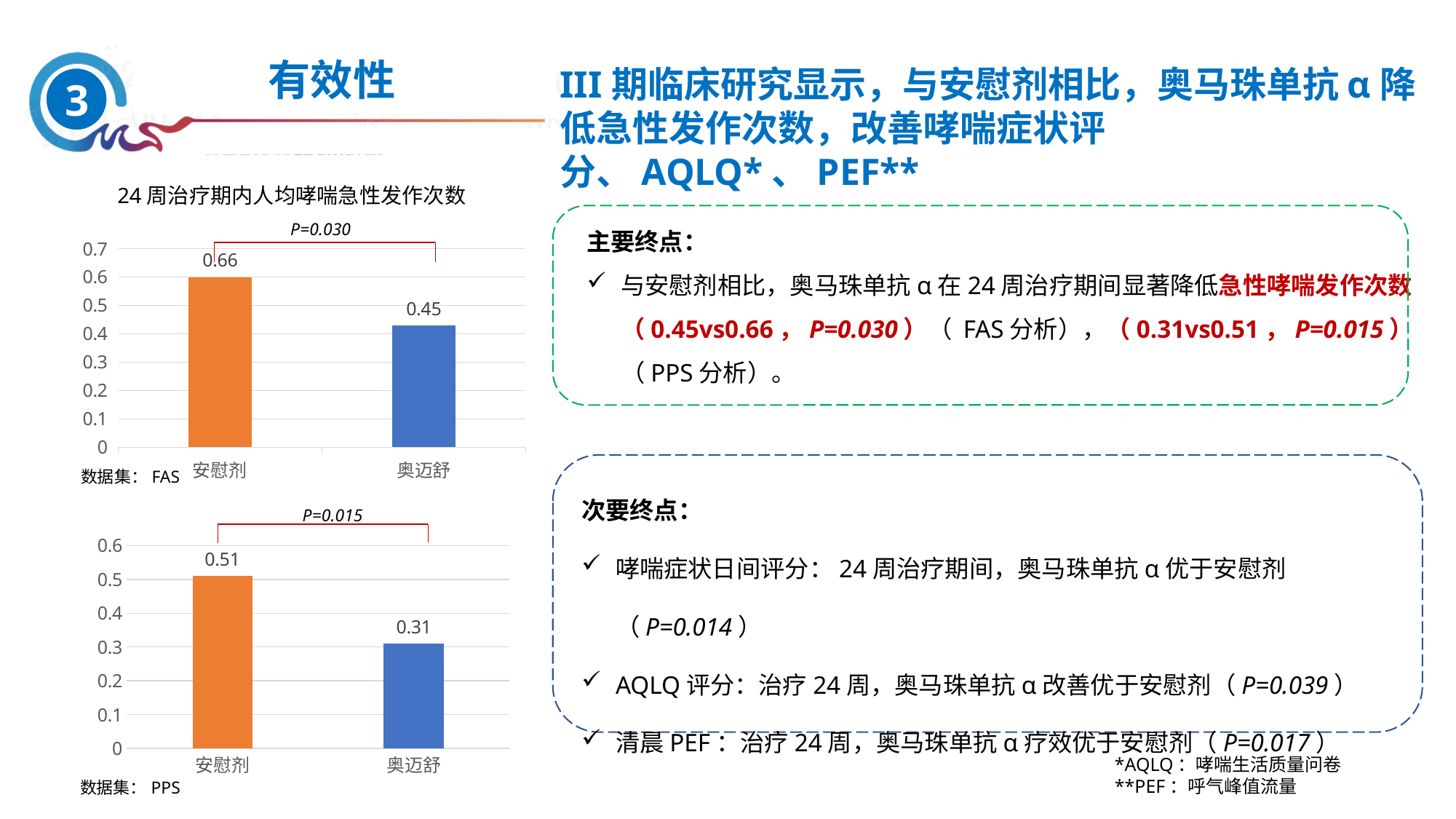
What kind of chart is the bottom chart (数据集: PPS)? bar chart In the top chart (数据集: FAS), which category has the higher value? 安慰剂 In the bottom chart (数据集: PPS), what is the value for 奥迈舒? 0.31 In the top chart (数据集: FAS), what is the value for 安慰剂? 0.66 In the top chart (数据集: FAS), what is the value for 奥迈舒? 0.45 In the bottom chart (数据集: PPS), what is the value for 安慰剂? 0.51 In the top chart (数据集: FAS), what is the difference between the values for 安慰剂 and 奥迈舒? 0.21 In the bottom chart (数据集: PPS), which category has the lower value? 奥迈舒 In the bottom chart (数据集: PPS), is the value for 安慰剂 greater or less than 0.4? greater How many categories are shown in the top chart (数据集: FAS)? 2 What is the title of the top chart? 24 周治疗期内人均哮喘急性发作次数 In the bottom chart (数据集: PPS), what is the difference between the values for 安慰剂 and 奥迈舒? 0.20